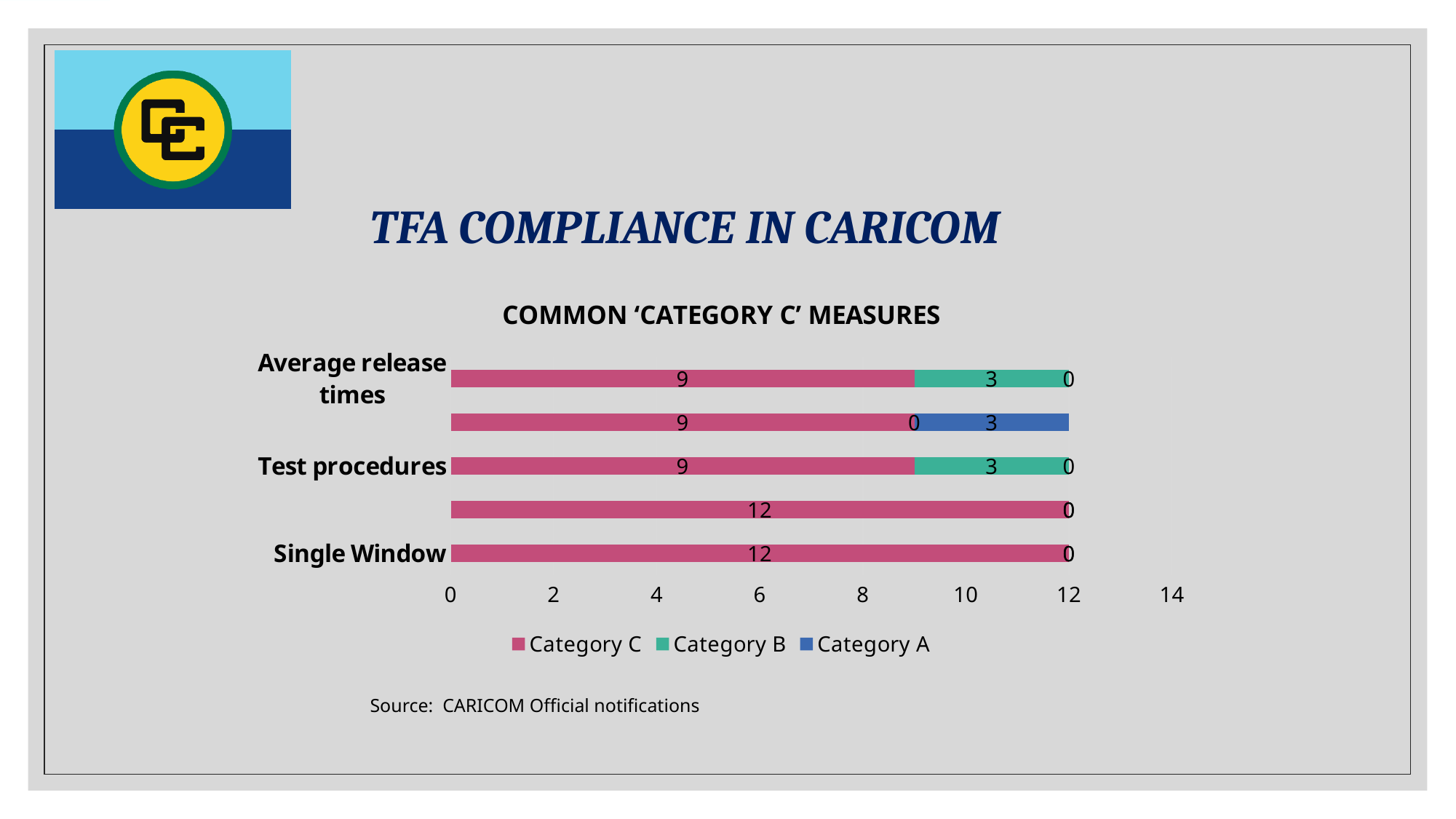
Which has the larger Category C value, Single Window or Average release times? Single Window What is the difference between the Category C value for Single Window and the Category C value for Test procedures? 3 What is the Category B value for Test procedures? 3 Which series is shown in blue in the legend? Category A How many series does the legend list? 3 What is the Category C value for Test procedures? 9 What is the Category A value for Average release times? 0 What is the Category C value for Single Window? 12 What is the total of the stacked bar for Average release times? 12 What is the title of the chart? COMMON 'CATEGORY C' MEASURES What kind of chart is shown on the slide? Bar chart What is the Category B value for Average release times? 3